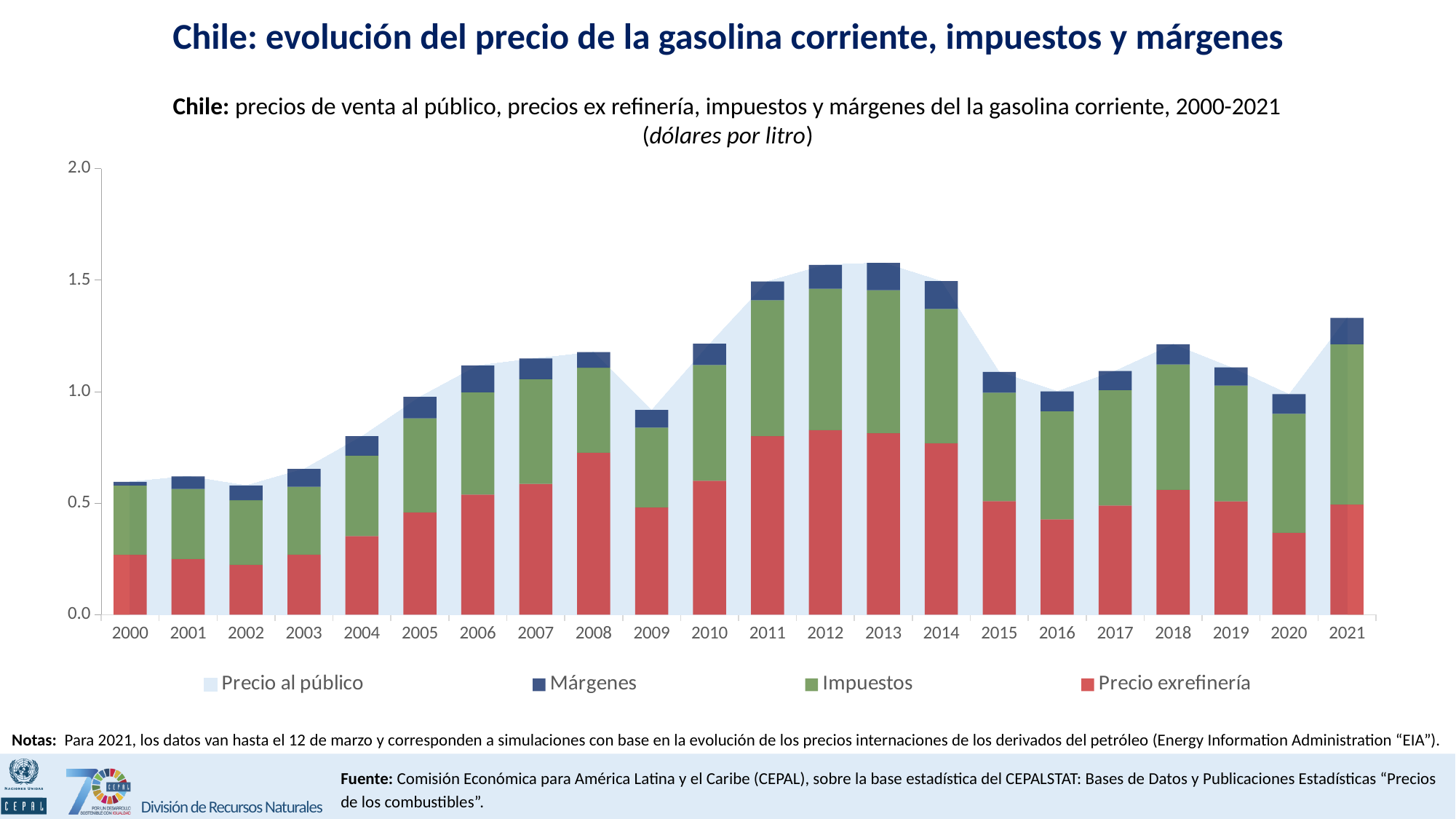
Which legend entry is shown in green? Impuestos Which year has the taller stacked bar, 2008 or 2009? 2008 Do the stacked bar totals rise or fall from 2013 to 2016? fall Is the total height of the stacked bar for 2021 greater or less than 1.0? greater Is the total height of the stacked bar for 2002 greater or less than 1.0? less Is the Precio exrefinería value for 2012 greater or less than 0.5? greater How many series does the legend list? 4 How many years are shown along the x axis? 22 What kind of chart is shown on the slide? combination of stacked bar and area chart Which year has the taller stacked bar, 2011 or 2015? 2011